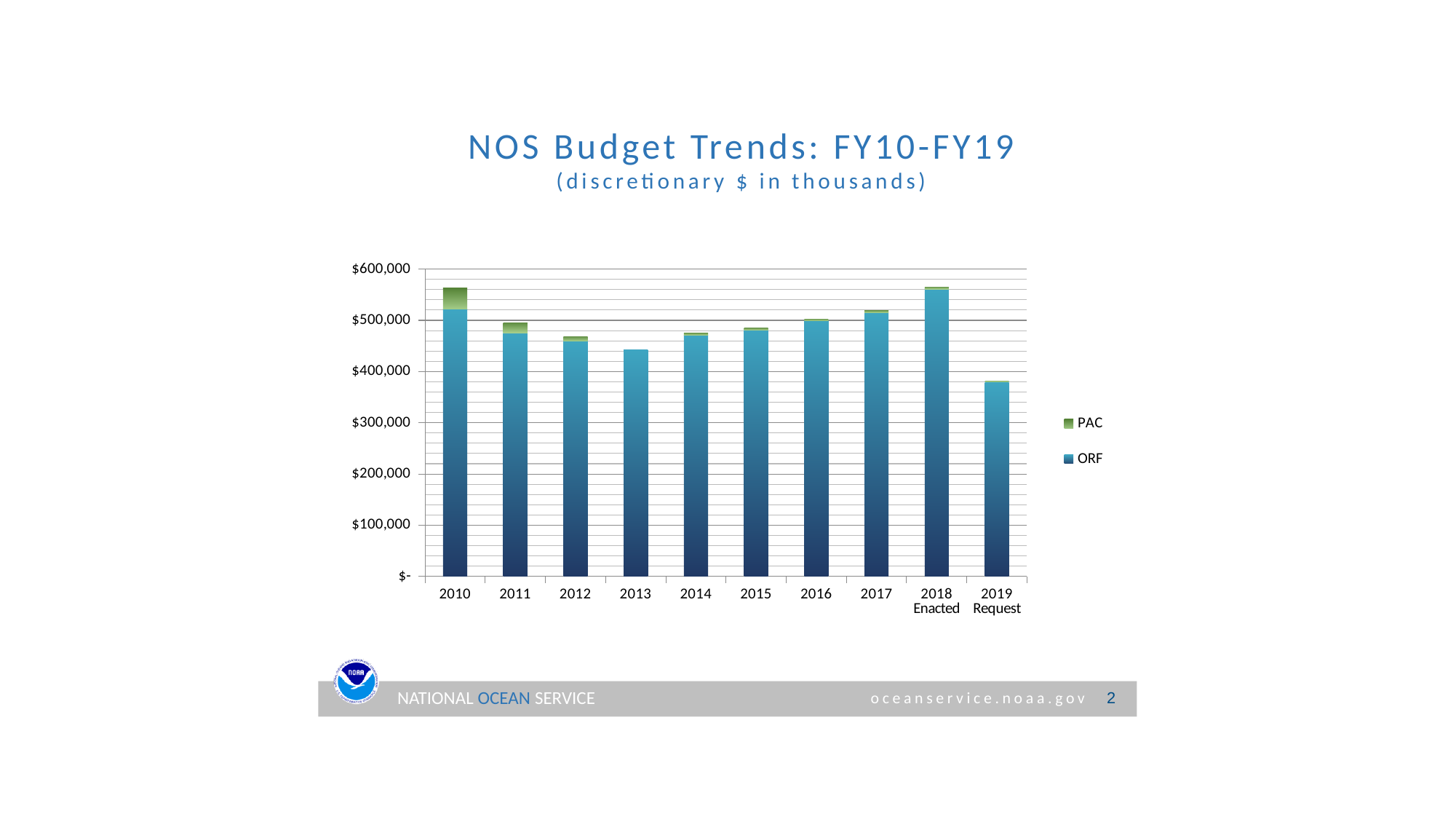
Is the total value for 2019 Request greater or less than $400,000? less How many series does the legend list? 2 Is the total value for 2010 greater or less than $500,000? greater Do the total budget values rise or fall from 2013 through 2018 Enacted? rise Which series is stacked on top of the bars? PAC What is the title of the chart? NOS Budget Trends: FY10-FY19 Is the total value for 2013 greater or less than $400,000? greater Which has the larger total budget, 2010 or 2013? 2010 Which category has the lowest total budget? 2019 Request What kind of chart is shown on the slide? stacked bar chart How many fiscal year categories are shown on the x axis? 10